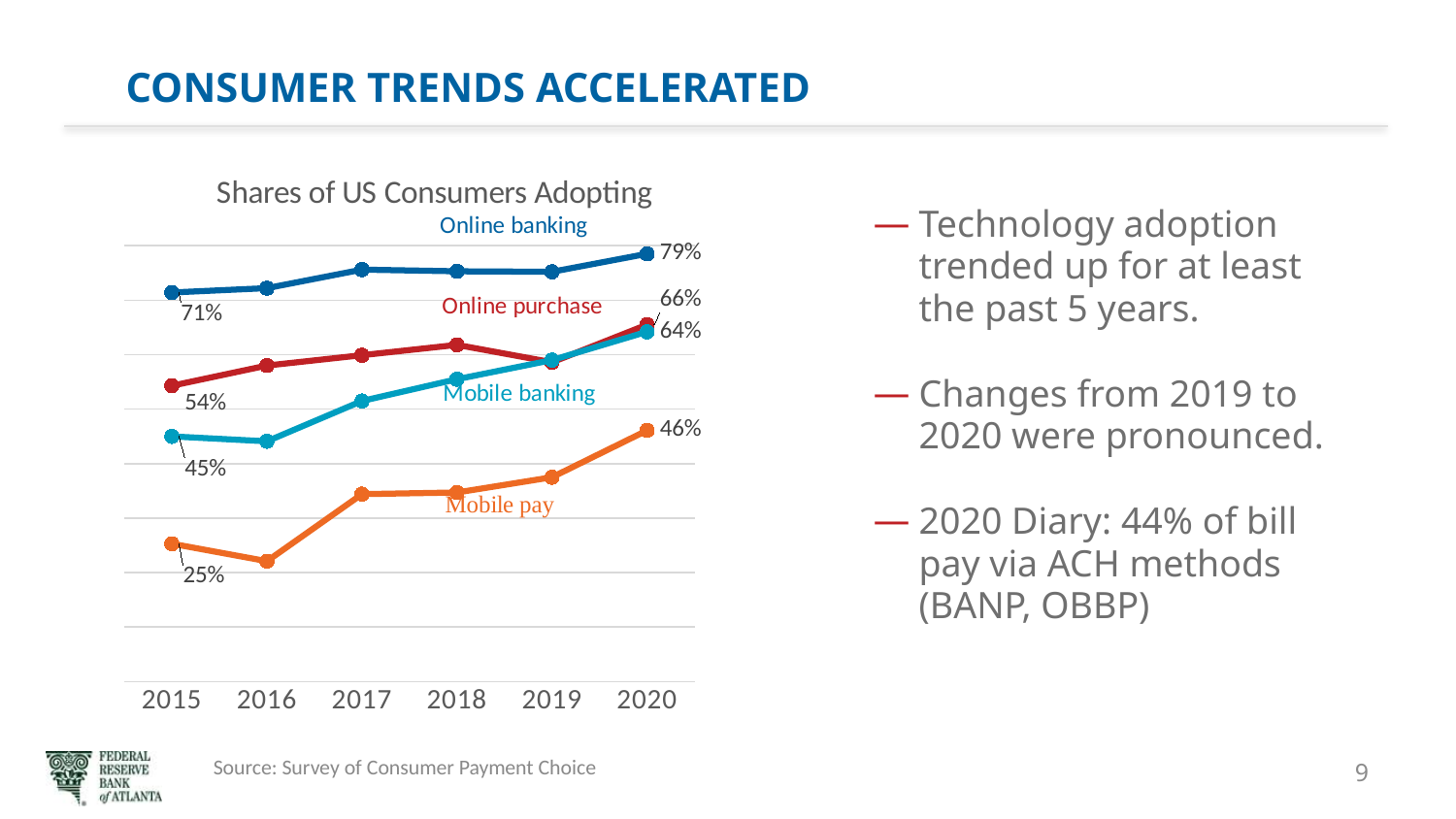
In 2020, which was larger: the online purchase share or the mobile banking share? Online purchase By how many percentage points did online banking adoption increase from 2015 to 2020? 8 percentage points What was the share of US consumers adopting mobile pay in 2015? 25% What share of US consumers had adopted online banking in 2020? 79% What is the title of the chart? Shares of US Consumers Adopting Which series had the lowest adoption share in 2015? Mobile pay By how many percentage points did mobile pay adoption increase from 2015 to 2020? 21 percentage points What was the mobile banking adoption share in 2015? 45% What kind of chart is shown on the slide? Line chart Which series had the highest adoption share in 2020? Online banking How many years are shown on the x axis of the chart? 6 What was the online purchase adoption share in 2020? 66%